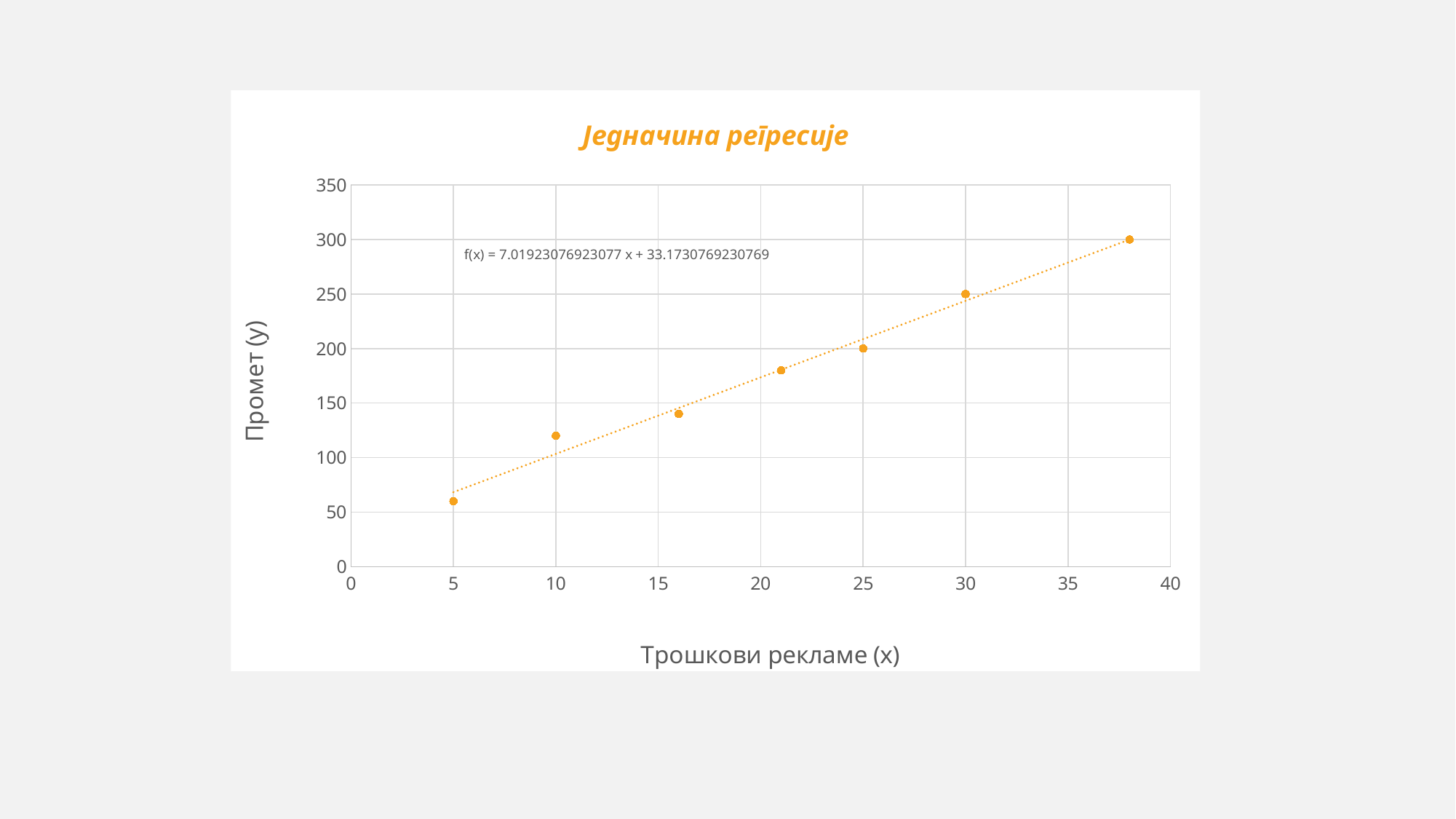
Is the y value of the point at x = 10 greater or less than 100? greater Is the y value of the point at x = 21 greater or less than 150? greater Do the plotted values rise or fall as x increases? rise Which point has the larger y value: the one at x = 10 or the one at x = 30? the one at x = 30 What is the highest y value reached by any plotted point? 300 What kind of chart is shown on the slide? scatter chart What is the title of the chart? Једначина регресије Is the y value of the point at x = 5 greater or less than 100? less What is the y value of the point at x = 30? 250 What is the y value of the point at x = 25? 200 What is the label of the x axis? Трошкови рекламе (x) How many data points are plotted on the chart? 7